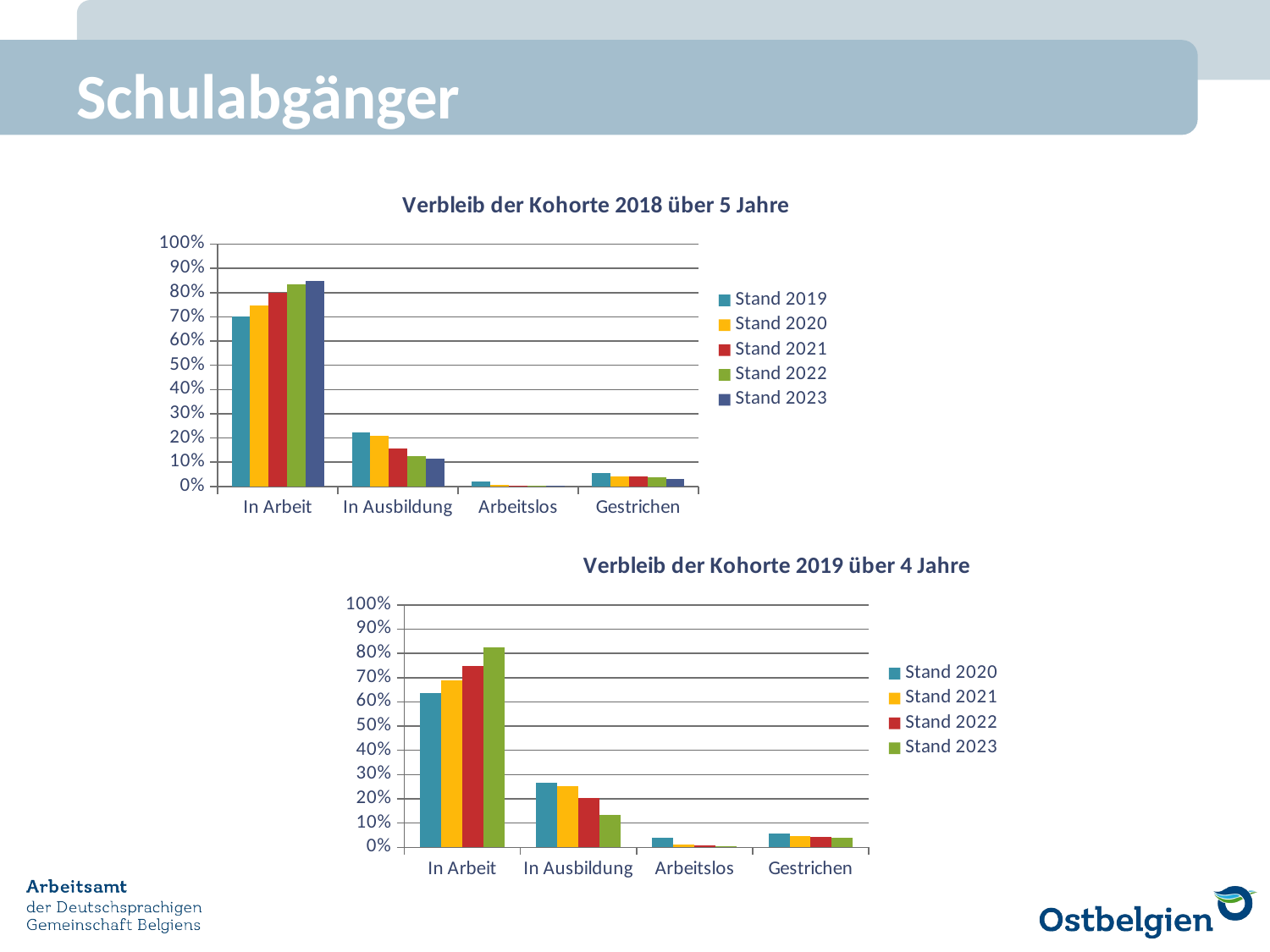
In the chart titled 'Verbleib der Kohorte 2018 über 5 Jahre', which category has the highest value for Stand 2023? In Arbeit In the chart titled 'Verbleib der Kohorte 2018 über 5 Jahre', what kind of chart is shown? bar chart In the chart titled 'Verbleib der Kohorte 2019 über 4 Jahre', is the value for 'In Arbeit' in Stand 2020 greater or less than 70%? less In the chart titled 'Verbleib der Kohorte 2019 über 4 Jahre', how many series does the legend list? 4 In the chart titled 'Verbleib der Kohorte 2018 über 5 Jahre', do the 'In Arbeit' values rise or fall from Stand 2019 to Stand 2023? rise In the chart titled 'Verbleib der Kohorte 2019 über 4 Jahre', which category has the lowest value for Stand 2023? Arbeitslos In the chart titled 'Verbleib der Kohorte 2018 über 5 Jahre', how many series does the legend list? 5 In the chart titled 'Verbleib der Kohorte 2019 über 4 Jahre', do the 'In Ausbildung' values rise or fall from Stand 2020 to Stand 2023? fall In the chart titled 'Verbleib der Kohorte 2018 über 5 Jahre', is the value for 'In Arbeit' in Stand 2019 greater or less than 60%? greater In the chart titled 'Verbleib der Kohorte 2019 über 4 Jahre', which is larger for 'In Arbeit': Stand 2020 or Stand 2023? Stand 2023 In the chart titled 'Verbleib der Kohorte 2018 über 5 Jahre', how many categories are shown on the x axis? 4 In the chart titled 'Verbleib der Kohorte 2018 über 5 Jahre', is the value for 'In Ausbildung' in Stand 2023 greater or less than 20%? less